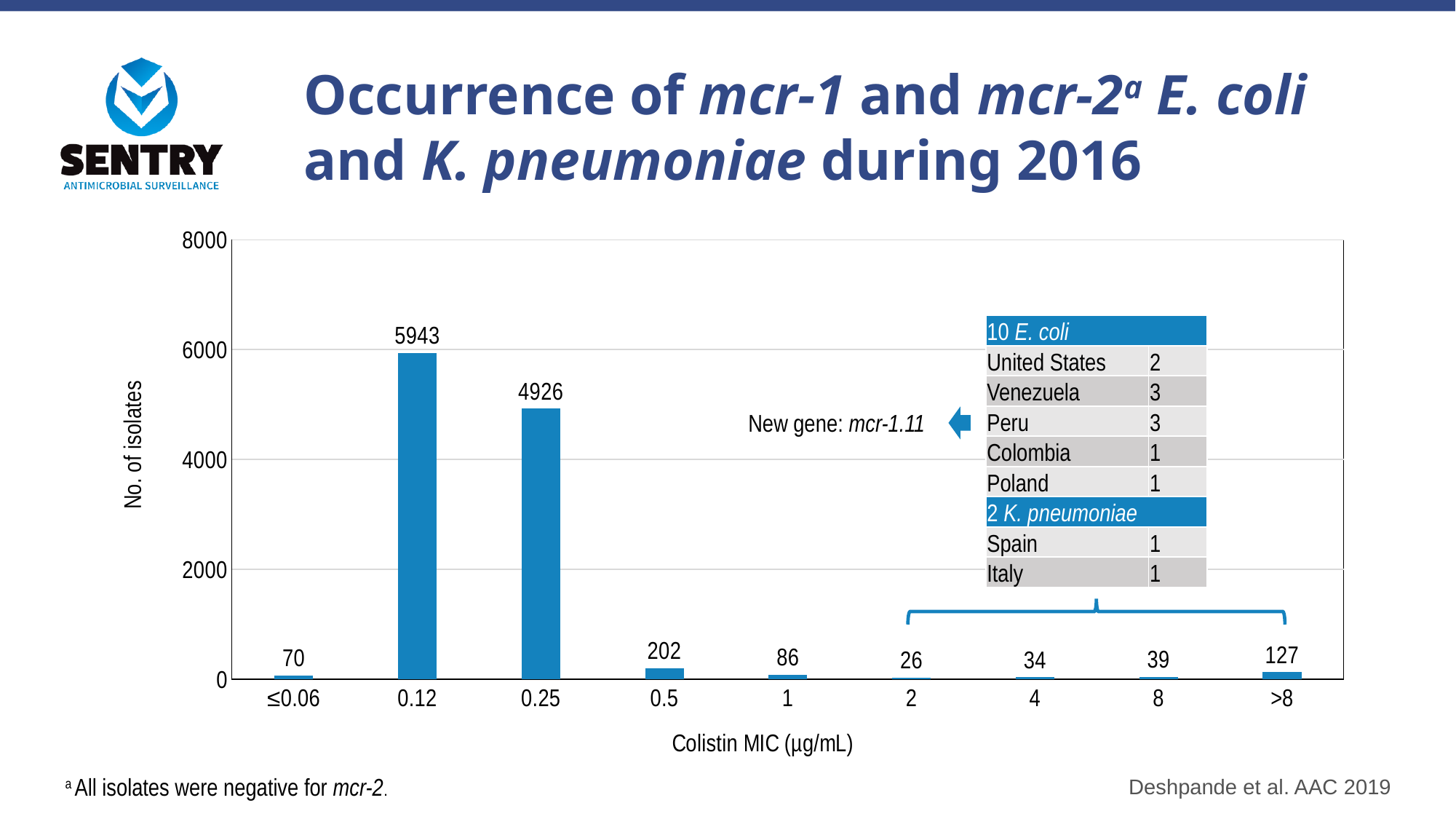
What type of chart is shown on the slide? bar chart How many isolates have a colistin MIC of 0.25 µg/mL? 4926 How many isolates have a colistin MIC of ≤0.06 µg/mL? 70 Which has more isolates: the 0.5 MIC category or the 1 MIC category? 0.5 Is the number of isolates at MIC 0.25 greater or less than 4000? greater What is the difference in the number of isolates between the 0.12 and 0.25 MIC categories? 1017 What is the label of the y axis of the chart? No. of isolates Which colistin MIC category has the highest number of isolates? 0.12 How many colistin MIC categories are shown on the x axis? 9 How many isolates have a colistin MIC of >8 µg/mL? 127 How many isolates have a colistin MIC of 0.12 µg/mL? 5943 Which colistin MIC category has the lowest number of isolates? 2